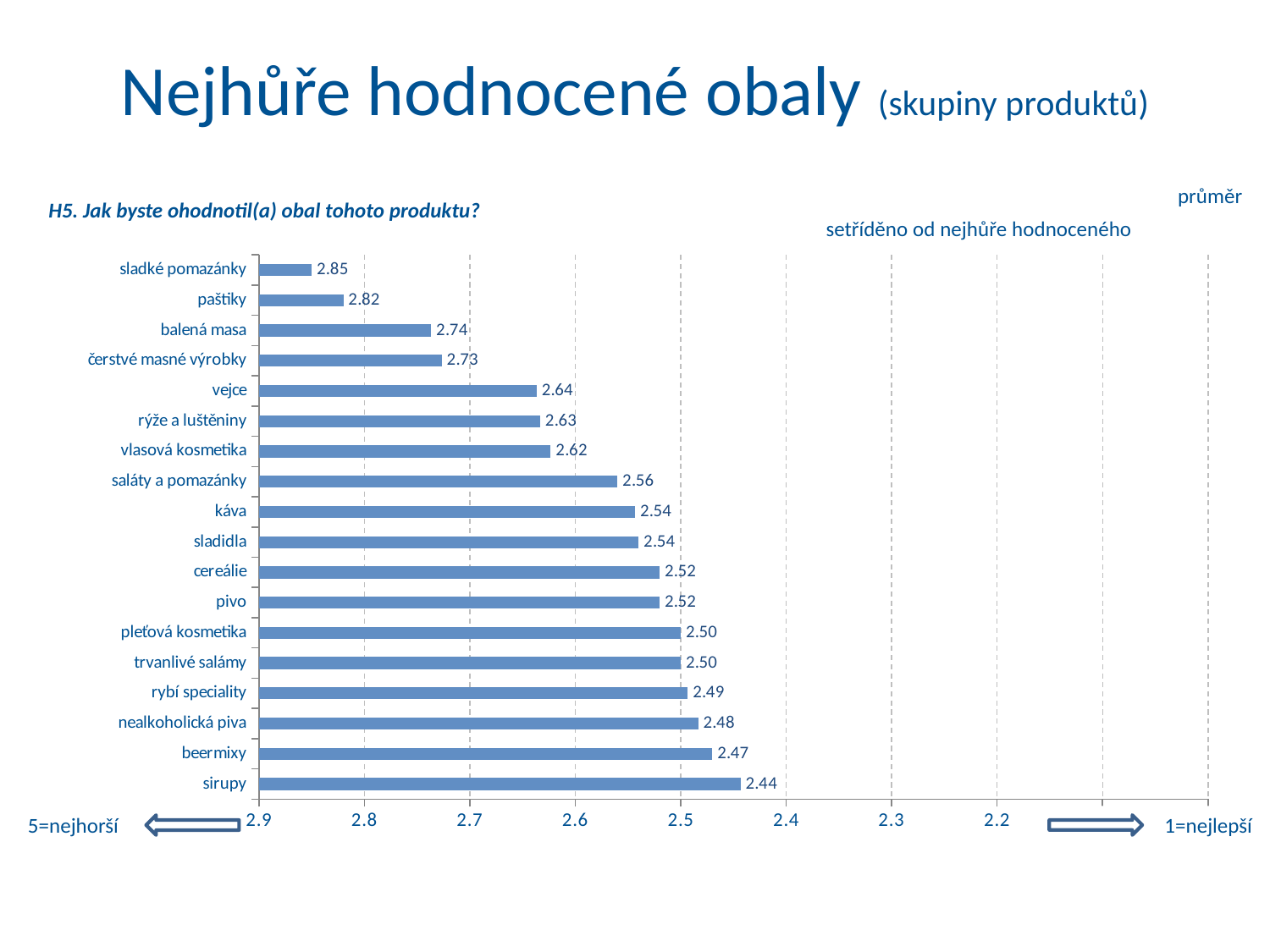
Which category has the lowest value? sirupy How many categories are shown in the chart? 18 What question is the chart based on, as stated above it? H5. Jak byste ohodnotil(a) obal tohoto produktu? What is the difference between the values for sladké pomazánky and sirupy? 0.41 What is the value for saláty a pomazánky? 2.56 What is the value for sladké pomazánky? 2.85 What kind of chart is shown on the slide? bar chart Which has a larger value, vlasová kosmetika or beermixy? vlasová kosmetika What is the difference between the values for paštiky and balená masa? 0.08 What is the value for vejce? 2.64 What is the value for sirupy? 2.44 Which category has the highest value? sladké pomazánky